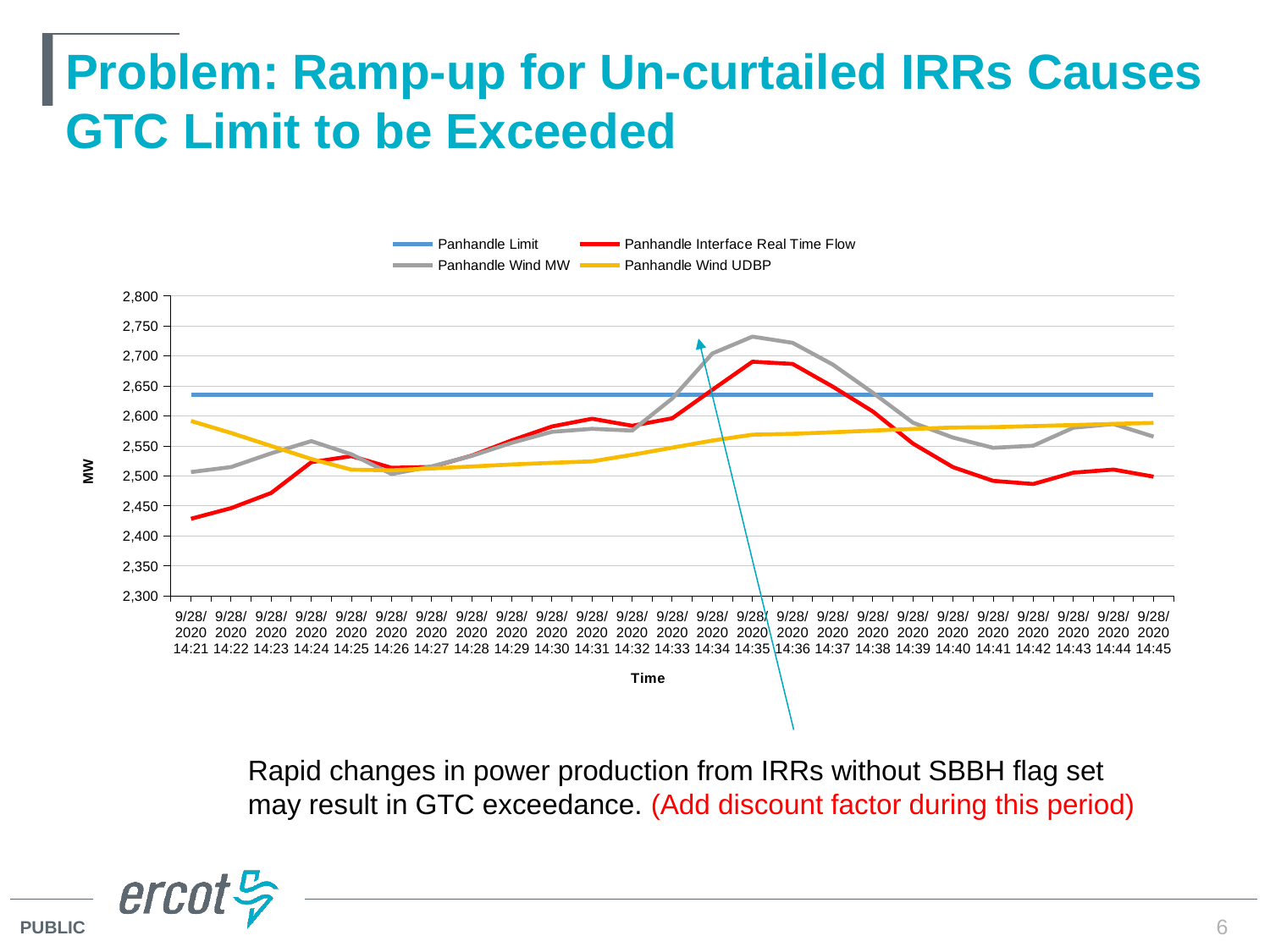
How many series does the chart legend list? 4 Is the Panhandle Wind MW value at 14:35 greater or less than 2,700 MW? greater What is the label of the chart's y axis? MW At 14:35, which is higher: Panhandle Wind MW or Panhandle Interface Real Time Flow? Panhandle Wind MW How many time points are plotted along the x axis? 25 At which time is the Panhandle Interface Real Time Flow at its lowest value? 9/28/2020 14:21 What kind of chart is shown on the slide? Line chart At which time does the Panhandle Interface Real Time Flow reach its highest value? 9/28/2020 14:35 At 14:21, which is higher: Panhandle Wind UDBP or Panhandle Interface Real Time Flow? Panhandle Wind UDBP Is the Panhandle Interface Real Time Flow at 14:21 greater or less than 2,450 MW? less Is the Panhandle Limit greater or less than 2,600 MW? greater Does the Panhandle Interface Real Time Flow rise or fall between 14:21 and 14:35? rise